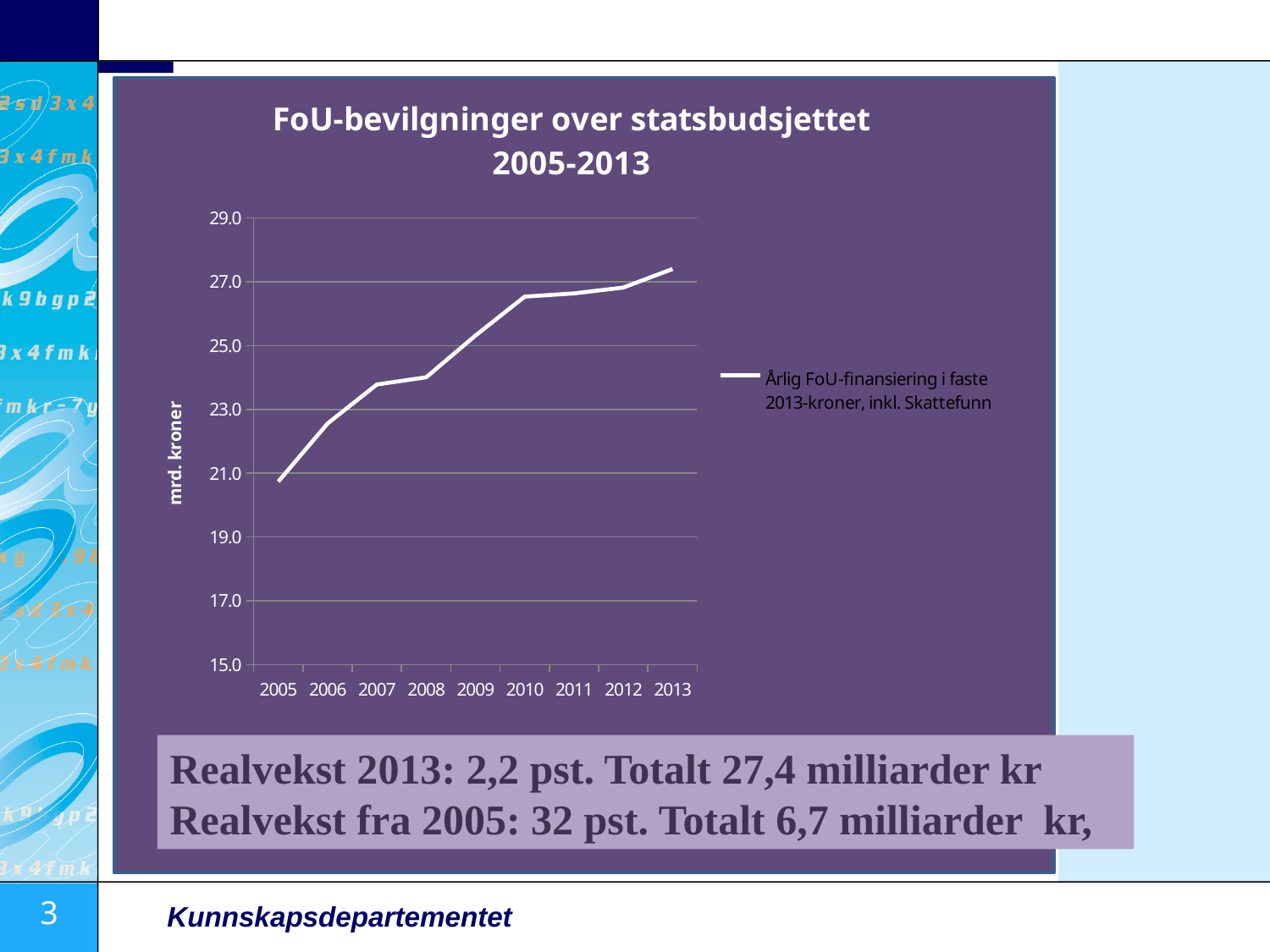
Which year has the highest value on the chart? 2013 Which year has the larger value, 2007 or 2011? 2011 Do the values rise or fall from 2005 to 2013? rise Is the value for 2005 greater or less than 21.0? less How many series does the legend list? 1 Which year has the lowest value on the chart? 2005 What is the title of the chart? FoU-bevilgninger over statsbudsjettet 2005-2013 Is the value for 2010 greater or less than 25.0? greater What kind of chart is shown on the slide? line chart Is the value for 2013 greater or less than 27.0? greater How many years are plotted along the x axis? 9 What is the label on the vertical axis of the chart? mrd. kroner